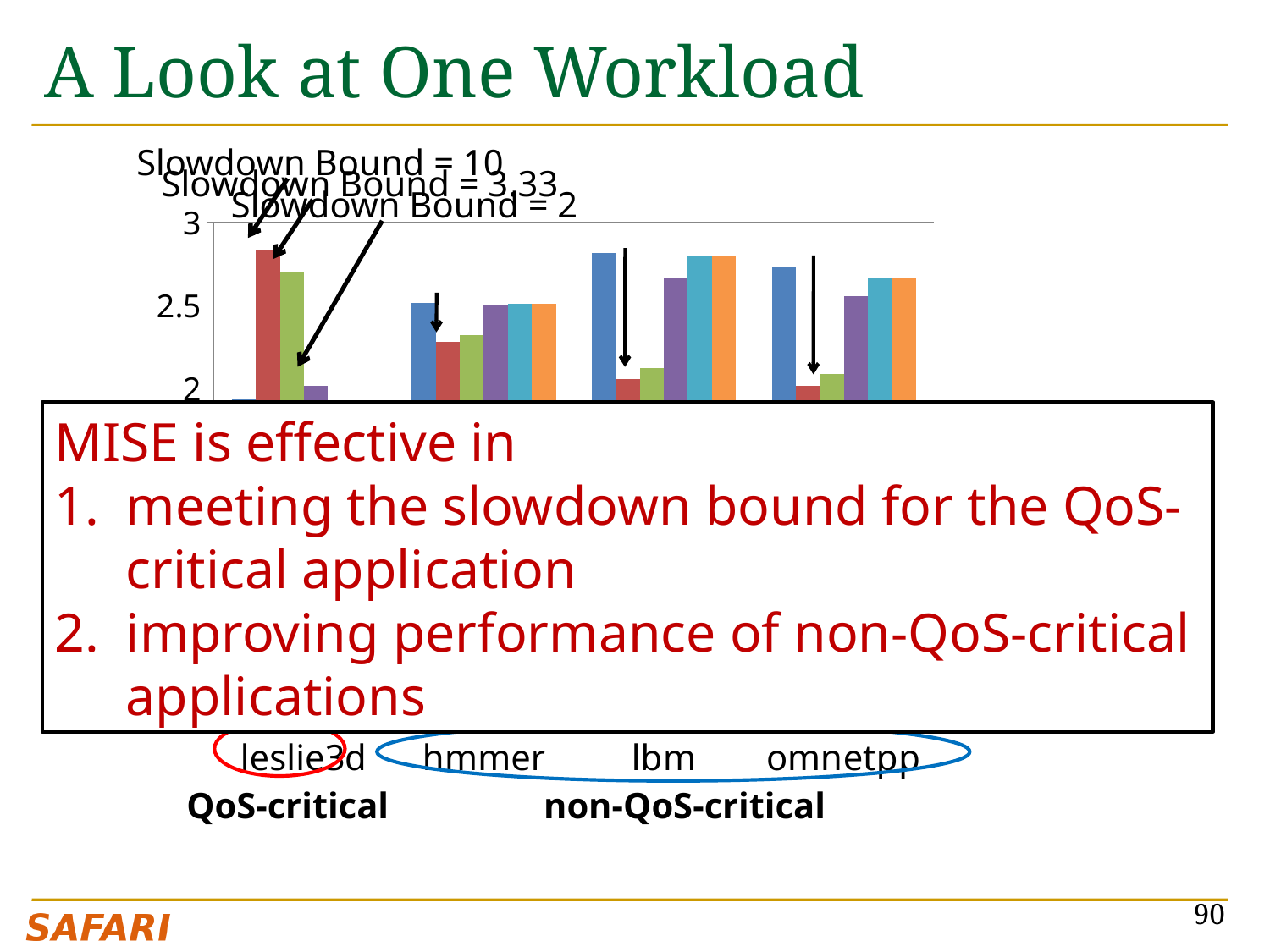
How many application categories are shown on the x axis of the chart? 4 What three slowdown bound values are annotated above the chart? 10, 3.33, 2 Which application on the x axis is labeled as QoS-critical? leslie3d Is the tallest bar for leslie3d greater or less than 3? less Is the tallest bar for omnetpp greater or less than 2.5? greater Is the tallest bar for omnetpp greater or less than 3? less What kind of chart is shown on the slide? bar chart